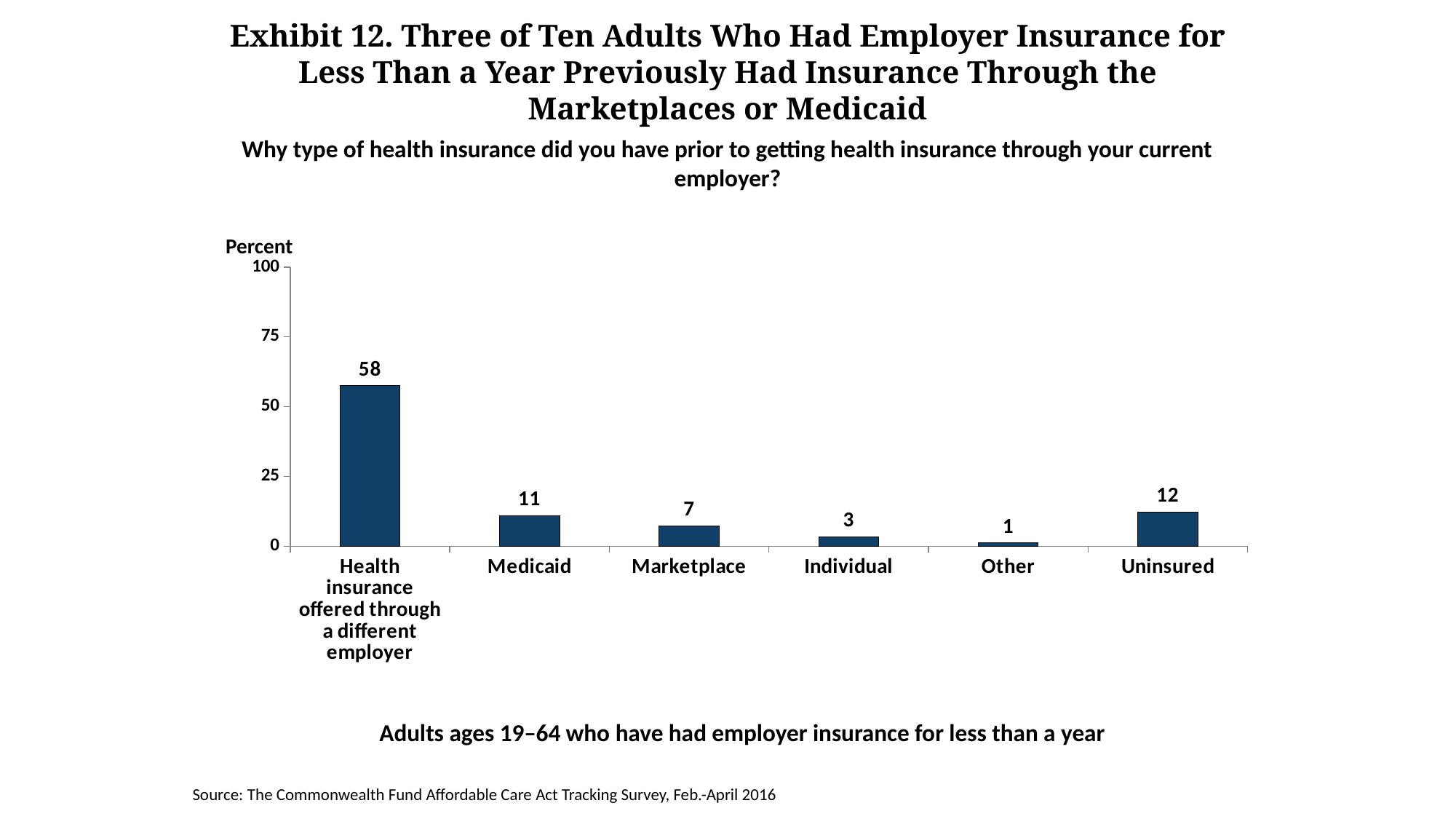
What is the difference between the values for Uninsured and Medicaid? 1 What is the value for Uninsured? 12 What is the label on the vertical axis? Percent Which is larger, the value for Medicaid or the value for Marketplace? Medicaid What kind of chart is shown on the slide? Bar chart Which category has the lowest value? Other What is the value for Medicaid? 11 What percent of adults previously had health insurance offered through a different employer? 58 What is the value for Marketplace? 7 What is the difference between the values for Marketplace and Individual? 4 How many categories are shown on the x axis? 6 Which category has the highest value? Health insurance offered through a different employer